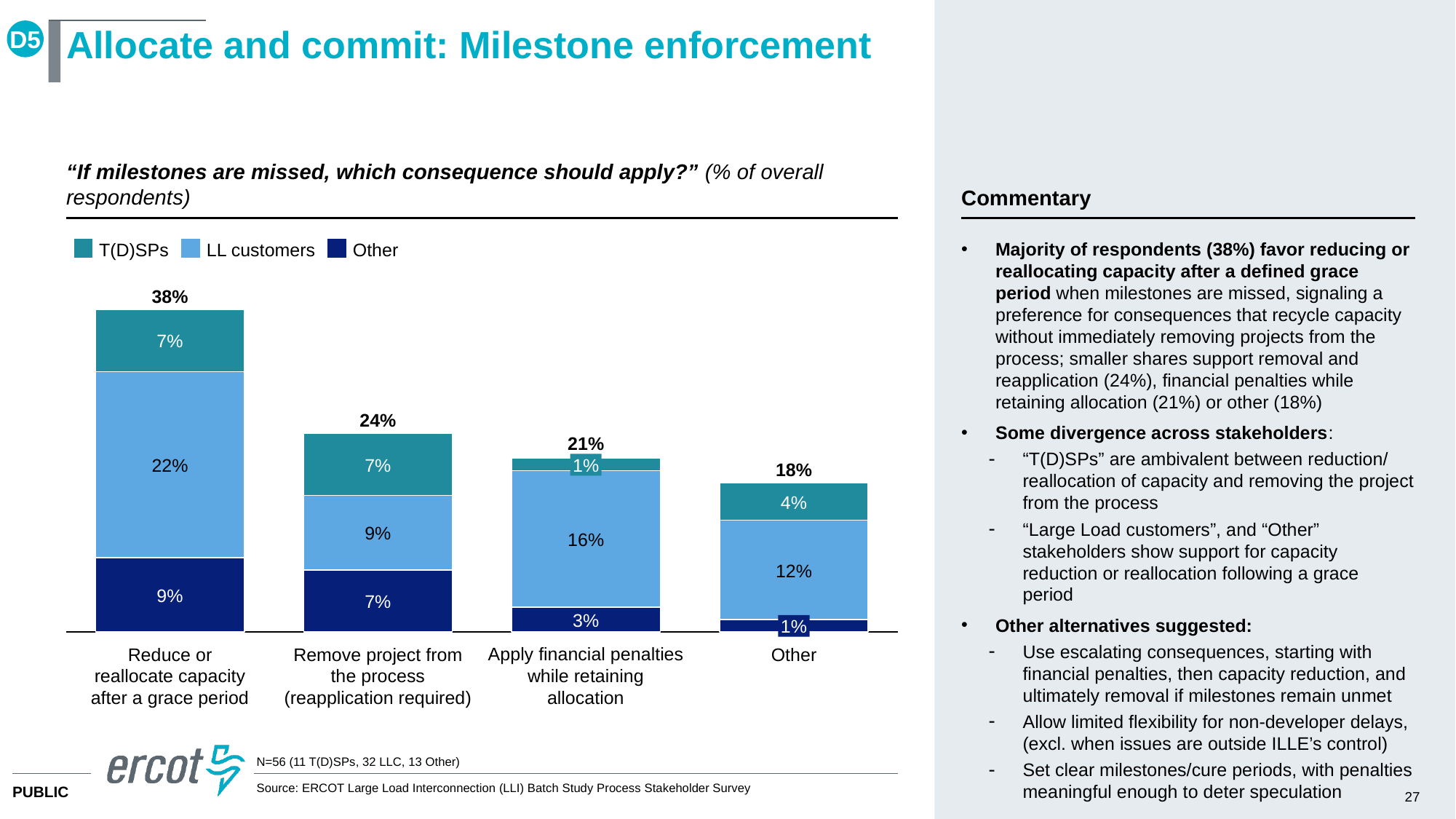
Which is larger: the T(D)SPs value for 'Remove project from the process (reapplication required)' or the T(D)SPs value for 'Apply financial penalties while retaining allocation'? Remove project from the process (reapplication required) What is the Other stakeholder value for 'Remove project from the process (reapplication required)'? 7% How many consequence categories are shown on the x axis? 4 What is the T(D)SPs value for 'Other'? 4% What is the total share of respondents for 'Reduce or reallocate capacity after a grace period'? 38% Which series is shown in the darkest blue colour in the legend? Other What is the difference between the LL customers values for 'Reduce or reallocate capacity after a grace period' and 'Remove project from the process (reapplication required)'? 13% What is the LL customers value for 'Apply financial penalties while retaining allocation'? 16% How many series does the legend list? 3 Which category has the highest total share of respondents? Reduce or reallocate capacity after a grace period What type of chart is shown on the slide? Stacked bar chart Which category has the lowest total share of respondents? Other